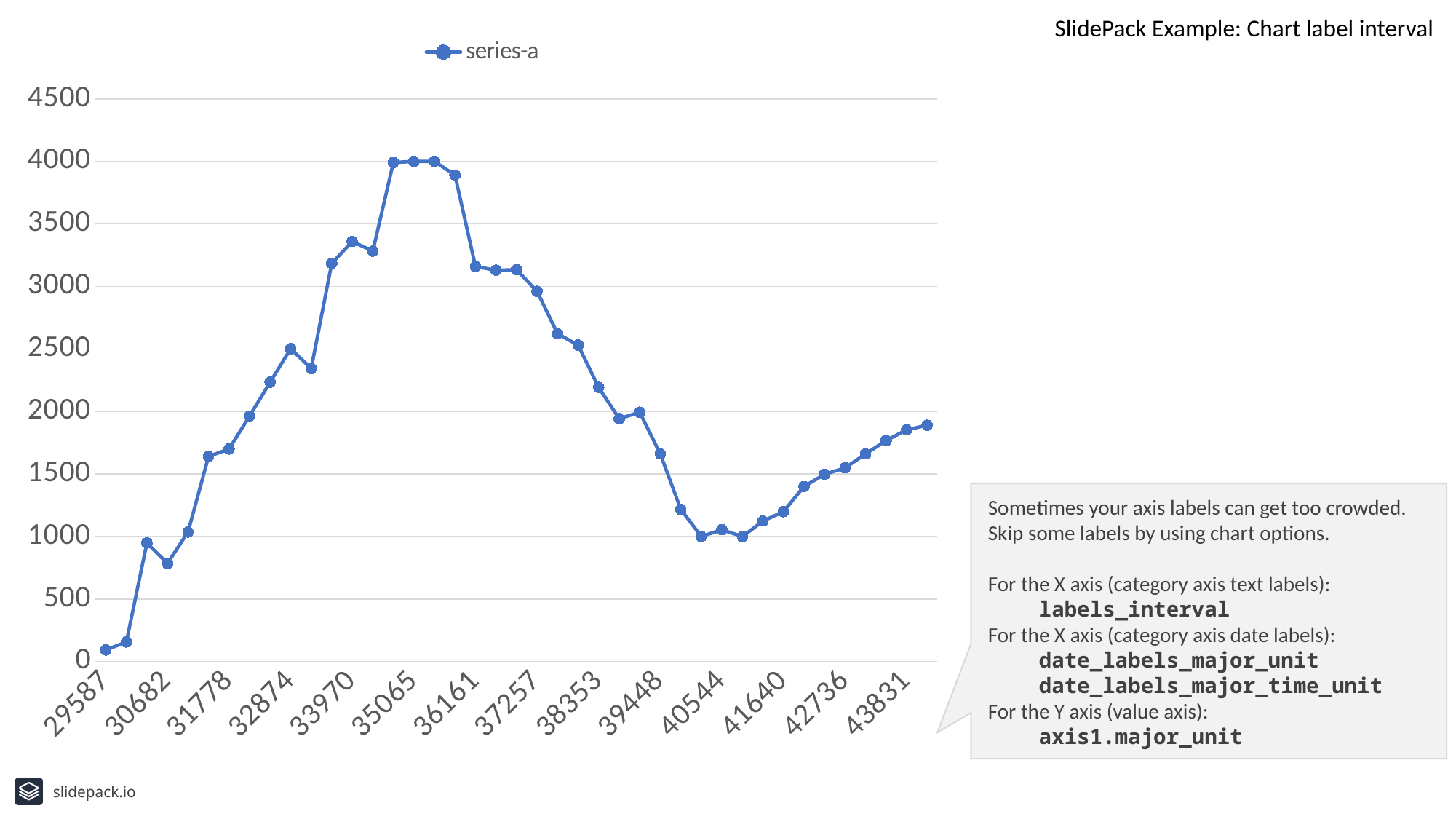
Do the values rise or fall between 35065 and 40544? fall What is the name of the series shown in the legend? series-a Is the value for 33970 greater or less than 3000? greater What kind of chart is shown on the slide? line chart How many labels are printed along the x axis? 14 Is the value for 43831 greater or less than 2000? less How many series does the legend list? 1 Is the value for 29587 greater or less than 500? less Which of the labeled x-axis categories has the lowest value? 29587 Which of the labeled x-axis categories has the highest value? 35065